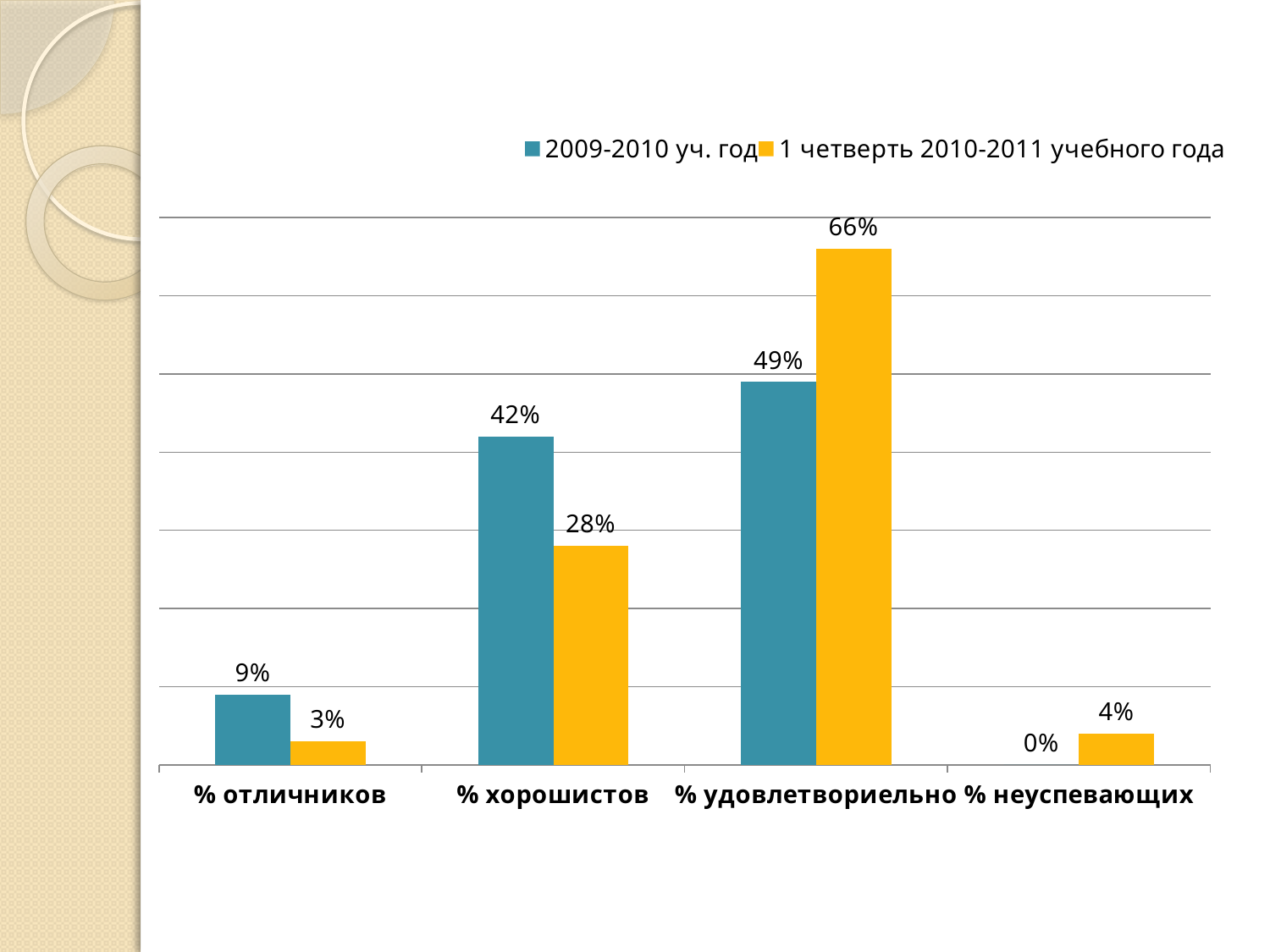
Which category has the lowest value in the 2009-2010 уч. год series? % неуспевающих What is the value for % отличников in the 2009-2010 уч. год series? 9% What is the value for % хорошистов in the 1 четверть 2010-2011 учебного года series? 28% What is the difference between the two series for % удовлетвориельно? 17% How many categories are shown on the x axis? 4 Which series has the larger value for % отличников? 2009-2010 уч. год What is the value for % неуспевающих in the 2009-2010 уч. год series? 0% What is the difference between the 2009-2010 уч. год and 1 четверть 2010-2011 учебного года values for % хорошистов? 14% What kind of chart is shown on the slide? Bar chart Which series has the larger value for % неуспевающих? 1 четверть 2010-2011 учебного года How many series does the legend list? 2 Which category has the highest value in the 1 четверть 2010-2011 учебного года series? % удовлетвориельно